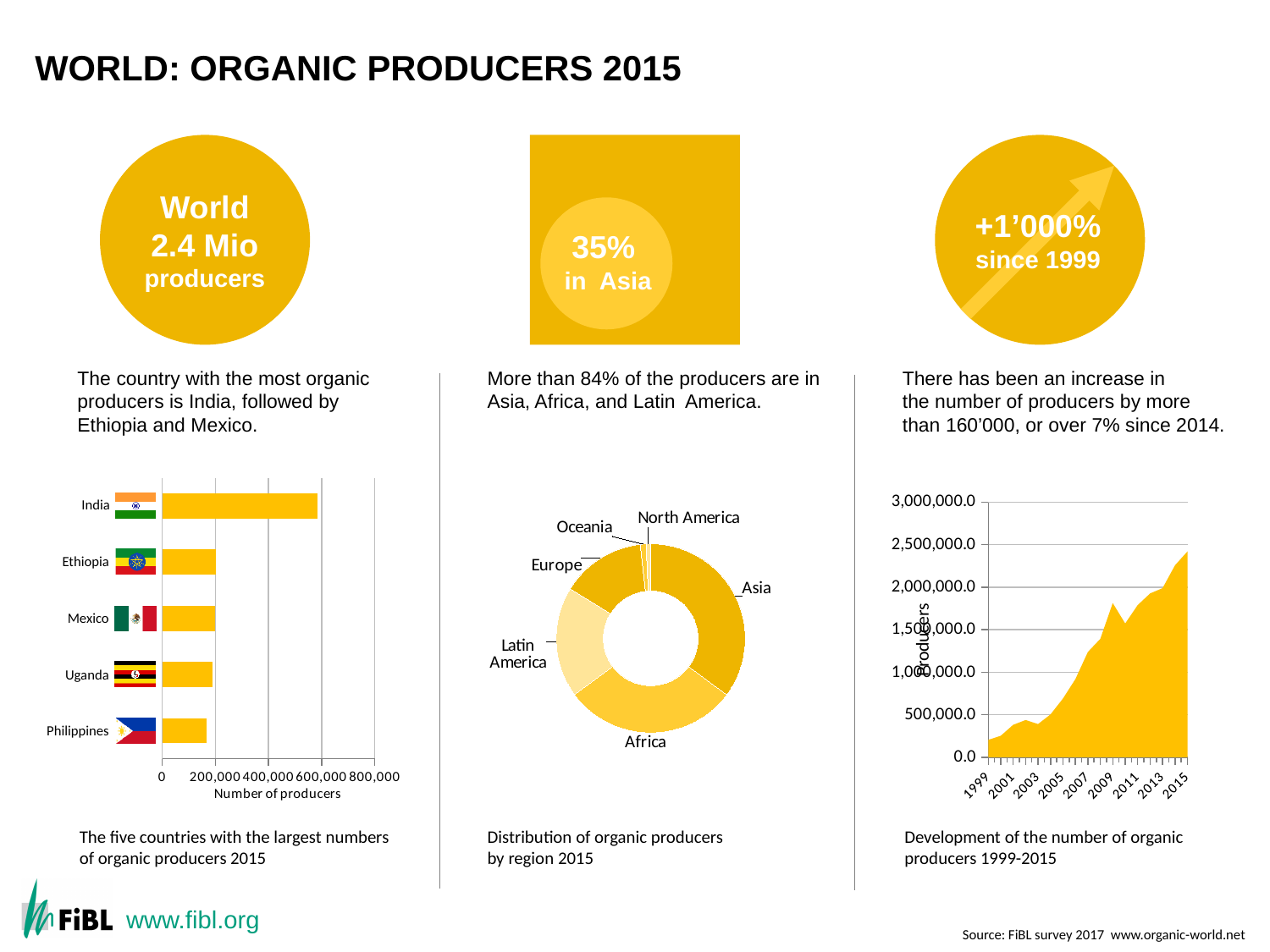
In the chart of the development of the number of organic producers 1999-2015, is the value for 2015 greater or less than 2,000,000? greater In the chart of the five countries with the largest numbers of organic producers 2015, which country has the lowest number of producers? Philippines In the chart of the distribution of organic producers by region 2015, which region has the largest share? Asia How many countries are shown in the chart of the five countries with the largest numbers of organic producers 2015? 5 In the chart of the five countries with the largest numbers of organic producers 2015, is the value for India greater or less than 400,000? greater In the chart of the five countries with the largest numbers of organic producers 2015, which country has the highest number of producers? India How many regions are shown in the chart of the distribution of organic producers by region 2015? 6 In the chart of the distribution of organic producers by region 2015, what share of producers is in Asia? 35% In the chart of the five countries with the largest numbers of organic producers 2015, which has more producers, India or Uganda? India In the chart of the development of the number of organic producers 1999-2015, do the values generally rise or fall from 1999 to 2015? rise What kind of chart is the chart of the five countries with the largest numbers of organic producers 2015? bar chart In the chart of the five countries with the largest numbers of organic producers 2015, is the value for the Philippines greater or less than 200,000? less